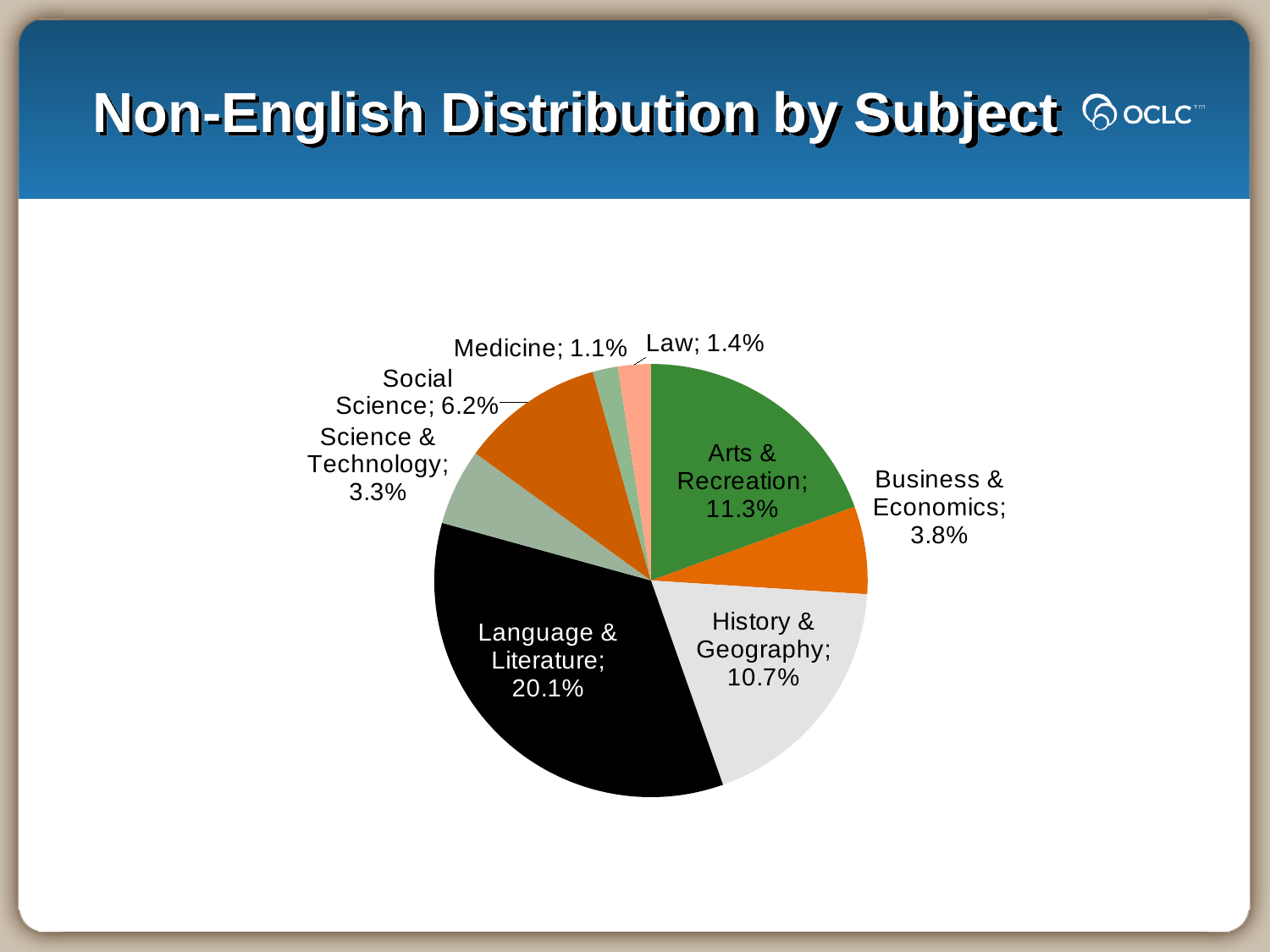
Which subject has the largest slice of the pie? Language & Literature Which subject has the smallest slice of the pie? Medicine Which is larger, the slice for Business & Economics or the slice for Science & Technology? Business & Economics What percentage is shown for History & Geography? 10.7% What percentage is shown for Arts & Recreation? 11.3% What is the title of the chart on the slide? Non-English Distribution by Subject What percentage is shown for Medicine? 1.1% How many subject slices are labeled in the pie chart? 8 What percentage is shown for Language & Literature? 20.1% What kind of chart is shown on the slide? pie chart What percentage is shown for Social Science? 6.2% What is the difference between the percentages for Language & Literature and History & Geography? 9.4%